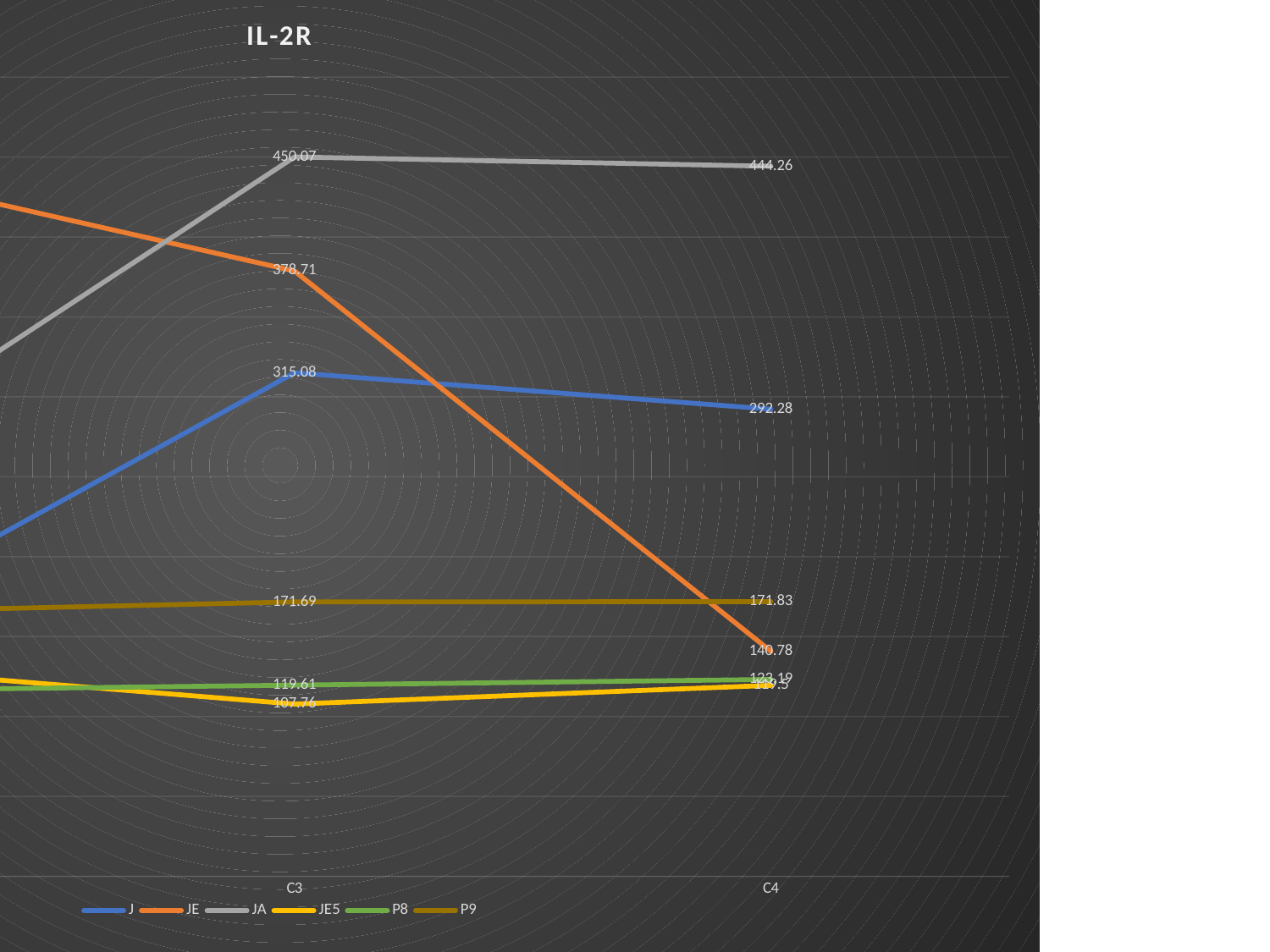
What is the title of the chart? IL-2R What is the difference between the JA values at C3 and C4? 5.81 What kind of chart is shown on the slide? line chart What is the value of P9 at C4? 171.83 How many series does the legend list? 6 Which series has the highest value at C3? JA What is the value of JE at C4? 140.78 What is the value of J at C3? 315.08 What is the value of JA at C3? 450.07 Does the JE series rise or fall from C3 to C4? fall Which series has the lowest value at C3? JE5 At C4, which is larger: J or JE? J